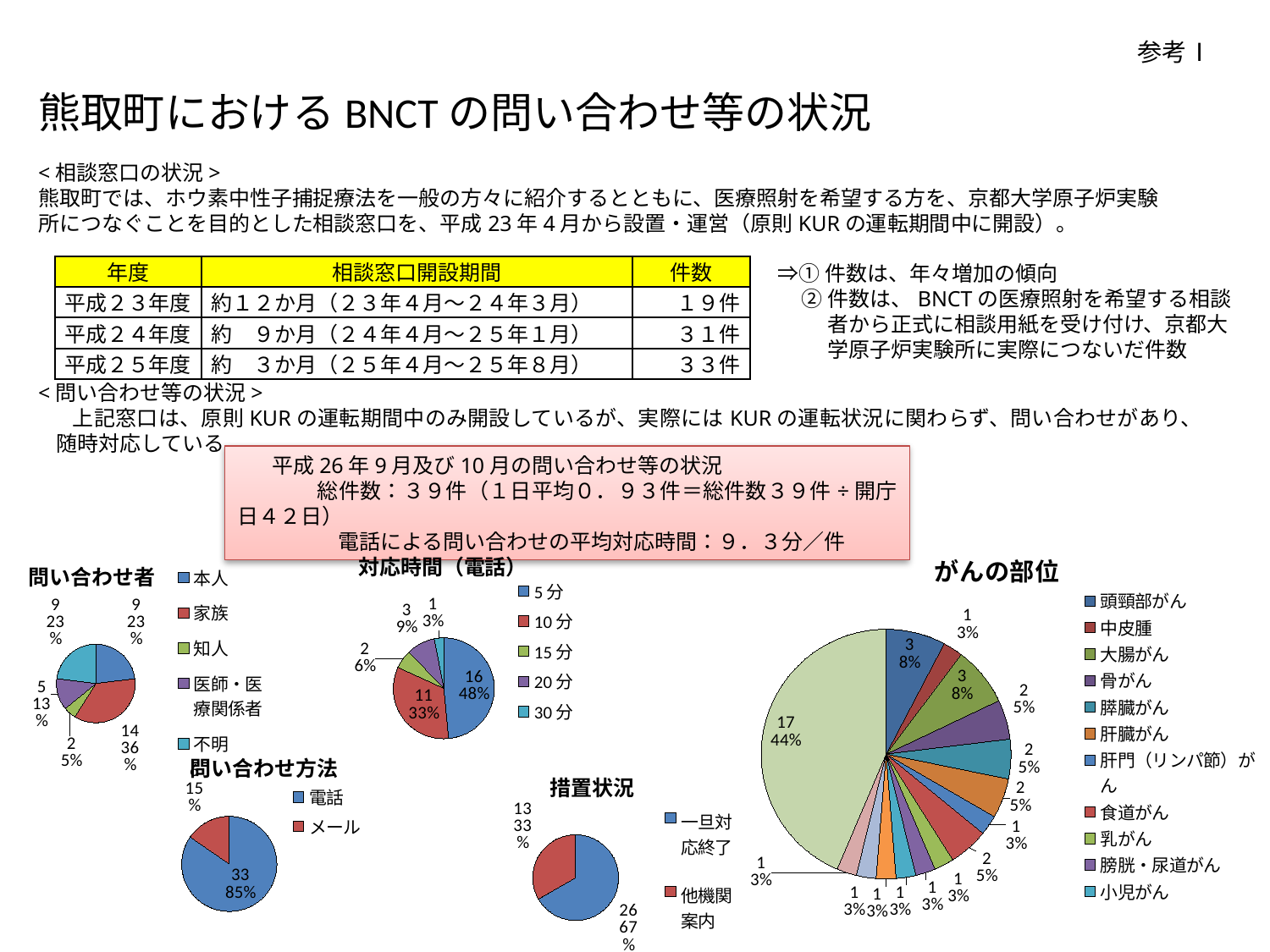
In the 問い合わせ者 chart, what share of the pie is 医師・医療関係者? 13% In the 問い合わせ者 chart, what is the value for 家族? 14 (36%) In the 問い合わせ方法 chart, what share of inquiries came by 電話? 85% In the 問い合わせ者 chart, which category has the smallest share? 知人 In the 対応時間（電話） chart, what is the difference between the counts for 5分 and 10分? 5 In the 措置状況 chart, what is the value for 他機関案内? 13 (33%) In the がんの部位 chart, what is the value for 頭頸部がん? 3 (8%) In the 対応時間（電話） chart, which category is the largest? 5分 What kind of chart is the 問い合わせ者 chart? pie chart In the 措置状況 chart, which is larger, 一旦対応終了 or 他機関案内? 一旦対応終了 How many categories does the legend of the 問い合わせ者 chart list? 5 In the 対応時間（電話） chart, what is the value for 5分? 16 (48%)